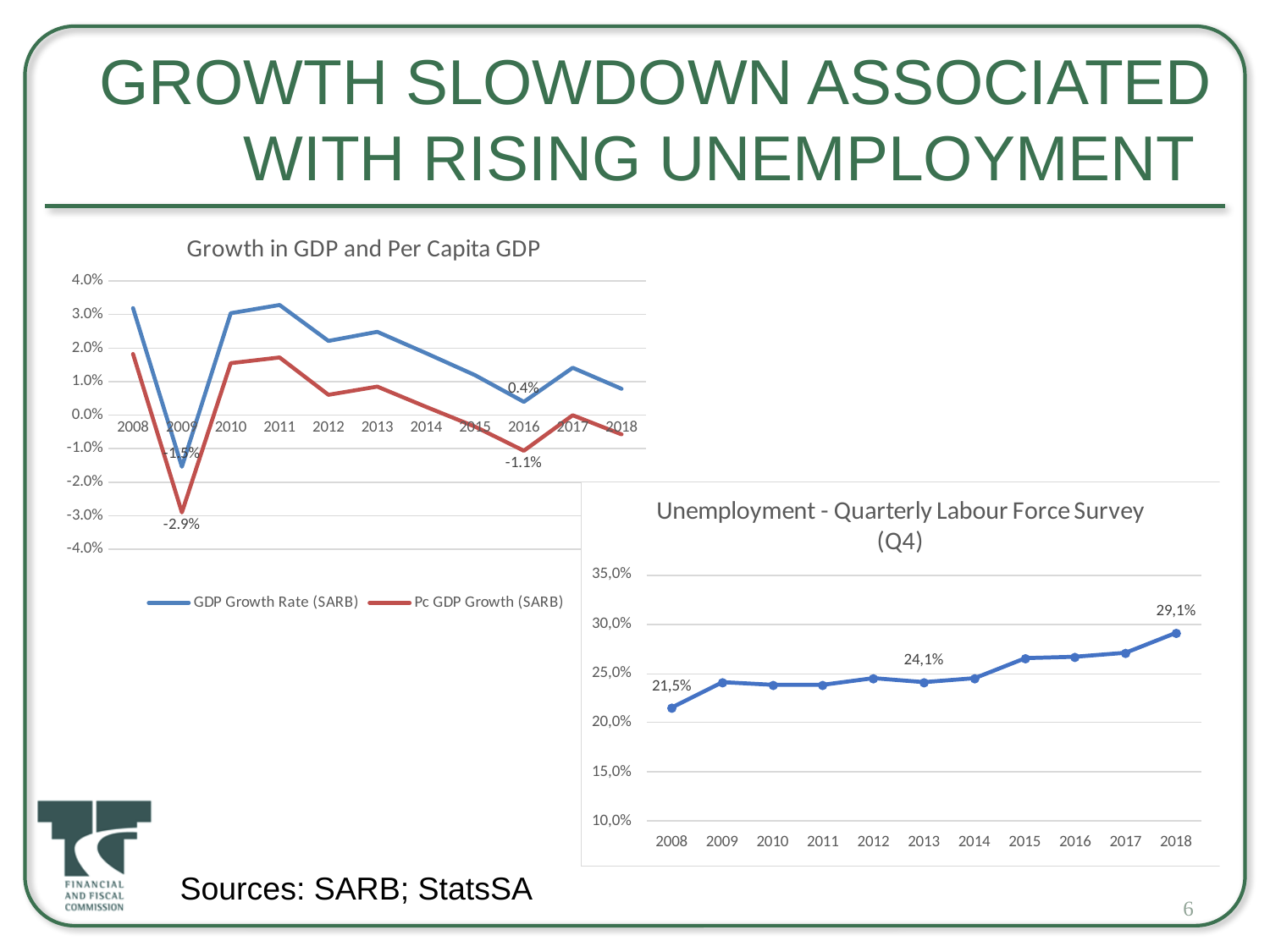
In the 'Unemployment - Quarterly Labour Force Survey (Q4)' chart, which year has the lowest unemployment rate? 2008 In the 'Unemployment - Quarterly Labour Force Survey (Q4)' chart, how many years are plotted on the x axis? 11 In the 'Unemployment - Quarterly Labour Force Survey (Q4)' chart, which year has the highest unemployment rate? 2018 What kind of chart is 'Growth in GDP and Per Capita GDP'? Line chart In the 'Unemployment - Quarterly Labour Force Survey (Q4)' chart, what is the value labelled for 2013? 24,1% In the 'Growth in GDP and Per Capita GDP' chart, what is the GDP Growth Rate (SARB) value for 2016? 0.4% In the 'Growth in GDP and Per Capita GDP' chart, which year has the lowest GDP Growth Rate (SARB)? 2009 In the 'Unemployment - Quarterly Labour Force Survey (Q4)' chart, what is the unemployment rate for 2018? 29,1% In the 'Unemployment - Quarterly Labour Force Survey (Q4)' chart, is the value for 2015 greater or less than 25,0%? greater In the 'Growth in GDP and Per Capita GDP' chart, how many series does the legend list? 2 In the 'Unemployment - Quarterly Labour Force Survey (Q4)' chart, what is the unemployment rate for 2008? 21,5% In the 'Growth in GDP and Per Capita GDP' chart, what is the Pc GDP Growth (SARB) value for 2009? -2.9%